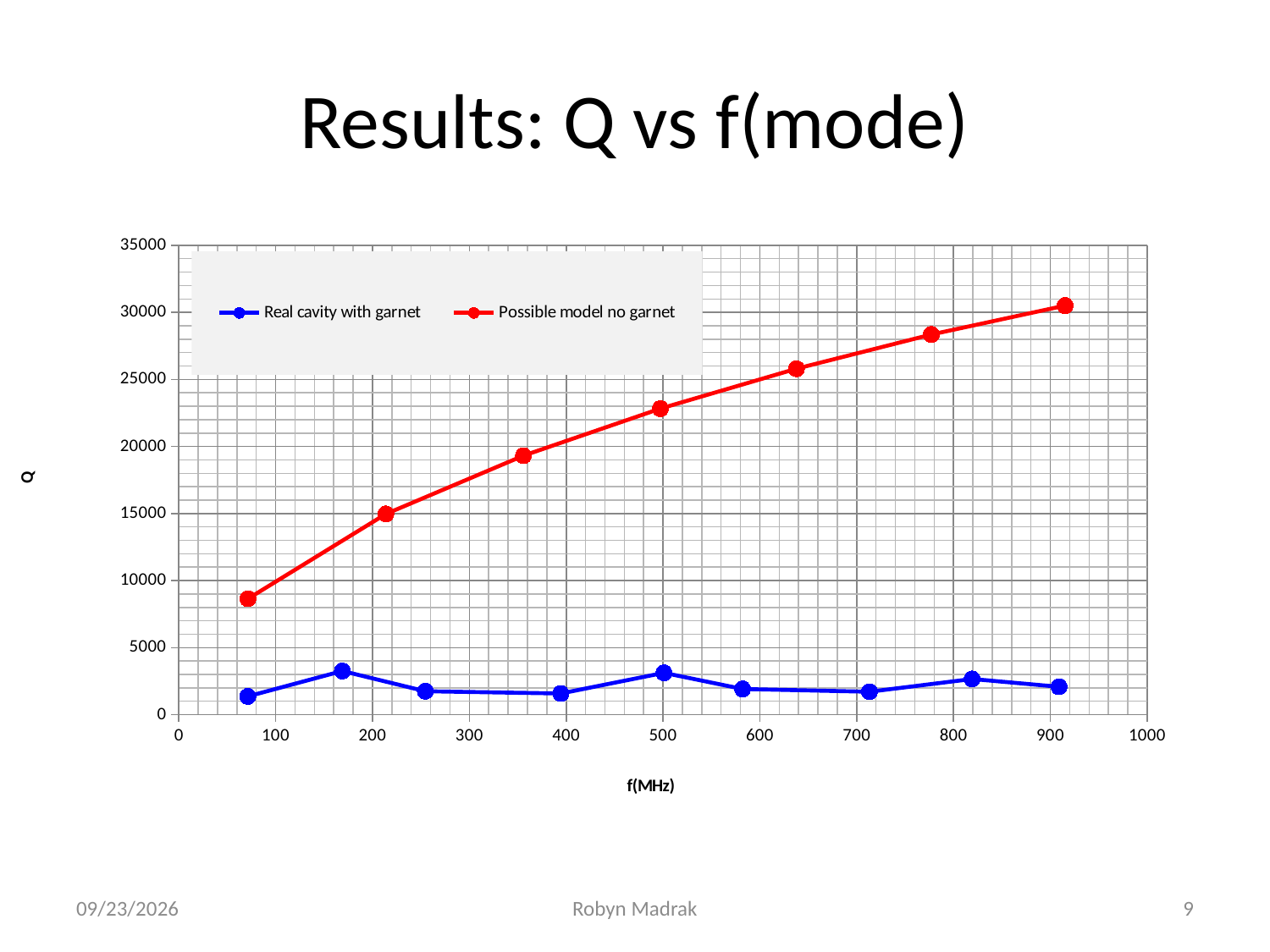
Is the Q value of the 'Possible model no garnet' series at about 500 MHz greater or less than 20000? greater How many data points are plotted for the 'Possible model no garnet' series? 7 Are all the Q values of the 'Real cavity with garnet' series greater or less than 5000? less What kind of chart is shown on the slide? line chart Does the 'Possible model no garnet' series rise or fall as frequency increases? rise What are the two series named in the legend? Real cavity with garnet; Possible model no garnet How many data points are plotted for the 'Real cavity with garnet' series? 9 Is the Q value of the first 'Possible model no garnet' point (near 70 MHz) greater or less than 10000? less What is the label of the x axis? f(MHz) Which series is drawn in red? Possible model no garnet How many series does the legend list? 2 Which series has the higher Q values across the frequency range, 'Real cavity with garnet' or 'Possible model no garnet'? Possible model no garnet